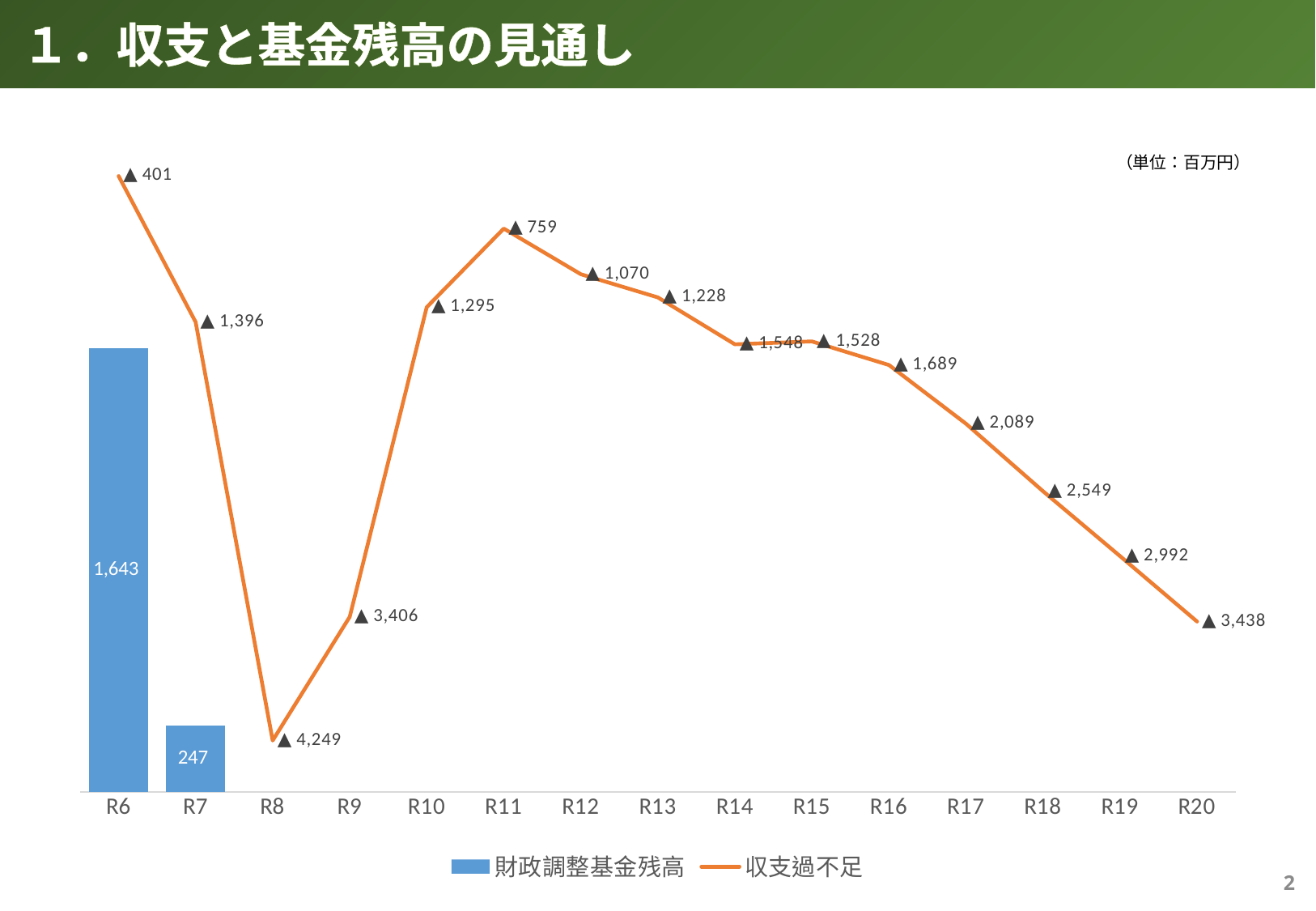
In which year does the 収支過不足 line reach its highest point? R6 What is the value of 収支過不足 for R20? ▲ 3,438 What kind of chart is shown on the slide? Combination bar and line chart Which is larger in magnitude, the 収支過不足 value for R17 or for R19? R19 How many years are shown on the x axis? 15 What is the value of 財政調整基金残高 for R7? 247 How many series does the legend list? 2 What is the difference between the 財政調整基金残高 values for R6 and R7? 1,396 In which year does the 収支過不足 line reach its lowest point? R8 What is the value of 財政調整基金残高 for R6? 1,643 What is the value of 収支過不足 for R8? ▲ 4,249 What is the value of 収支過不足 for R11? ▲ 759